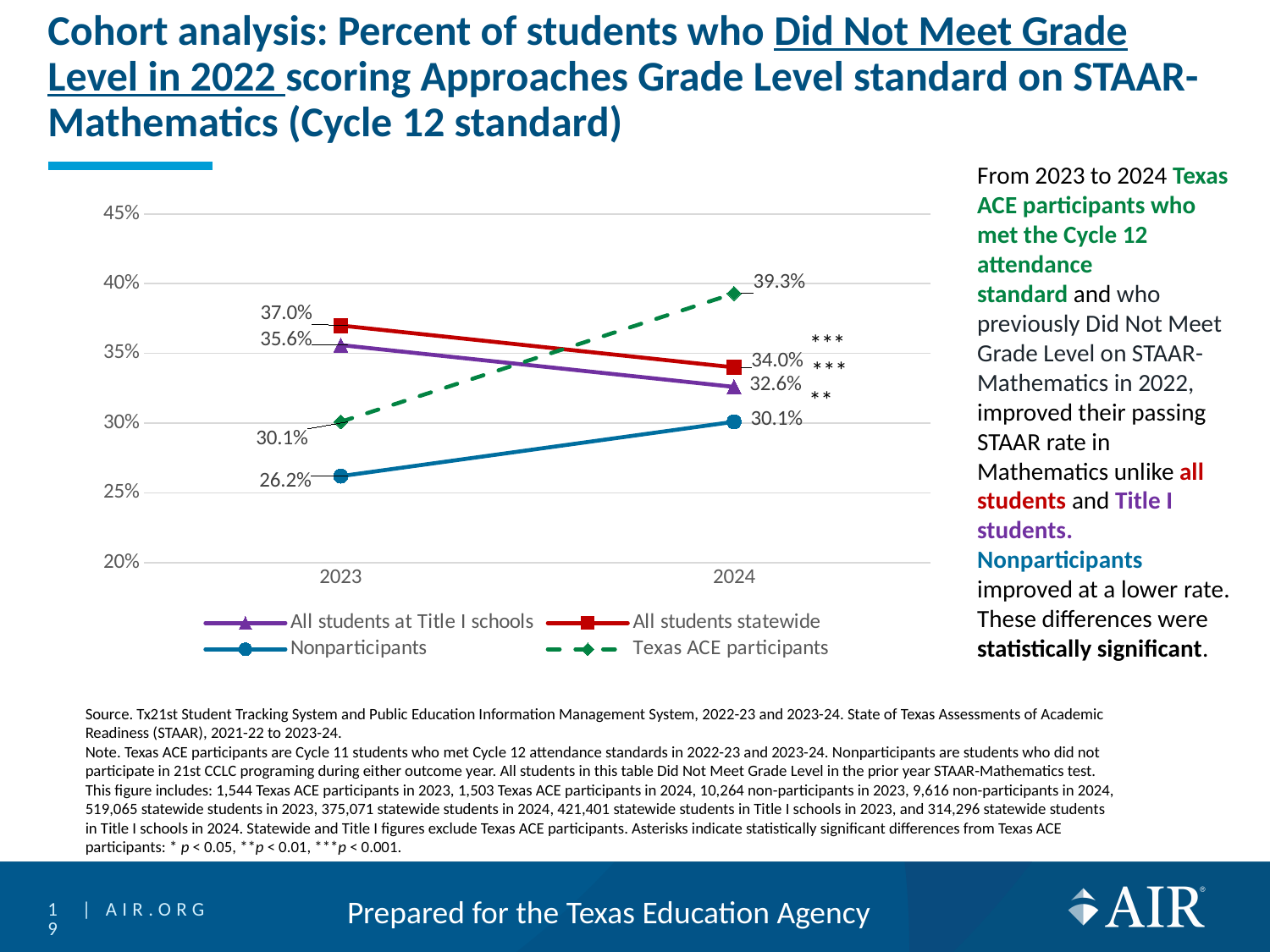
Which series had the lowest value in 2023? Nonparticipants What kind of chart is shown on the slide? Line chart What was the value for All students at Title I schools in 2024? 32.6% By how many percentage points did the Texas ACE participants value change from 2023 to 2024? 9.2 percentage points What was the value for All students statewide in 2023? 37.0% How many years are shown on the x axis? 2 What was the value for Texas ACE participants in 2024? 39.3% Did the value for All students statewide rise or fall from 2023 to 2024? Fall In 2024, which was larger: the value for All students statewide or the value for Nonparticipants? All students statewide Which series had the highest value in 2024? Texas ACE participants What was the value for Nonparticipants in 2023? 26.2% How many series does the legend list? 4